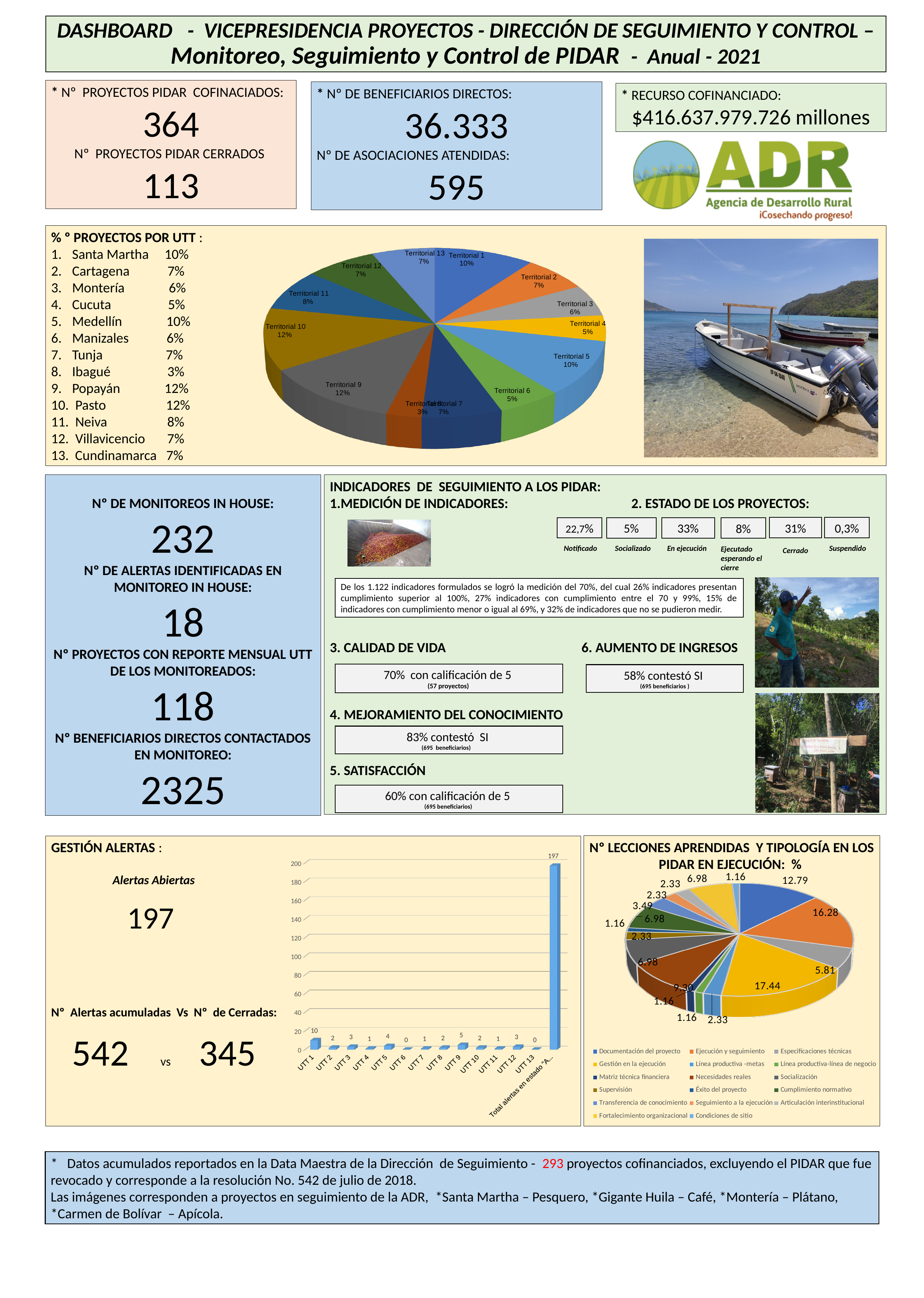
In the pie chart 'N° LECCIONES APRENDIDAS Y TIPOLOGÍA EN LOS PIDAR EN EJECUCIÓN', what is the largest value labeled on a slice? 17.44 In the pie chart '% PROYECTOS POR UTT', how many slices (territoriales) are there? 13 In the 'GESTIÓN ALERTAS' bar chart, what is the value of the last bar, 'Total alertas en estado A...'? 197 What type of chart is used in the 'GESTIÓN ALERTAS' section? Bar chart In the 'GESTIÓN ALERTAS' bar chart, what is the value for UTT 1? 10 In the 'GESTIÓN ALERTAS' bar chart, what is the value for UTT 9? 5 In the pie chart '% PROYECTOS POR UTT', what is the difference between the shares of Territorial 10 and Territorial 4? 7% In the pie chart '% PROYECTOS POR UTT', what percentage is shown for Territorial 11? 8% In the pie chart '% PROYECTOS POR UTT', which is larger, the share of Territorial 5 or Territorial 6? Territorial 5 In the pie chart '% PROYECTOS POR UTT', which territorial has the smallest share? Territorial 8 In the 'GESTIÓN ALERTAS' bar chart, which UTT has the highest value among UTT 1 to UTT 13? UTT 1 In the pie chart '% PROYECTOS POR UTT', what percentage is shown for Territorial 9? 12%